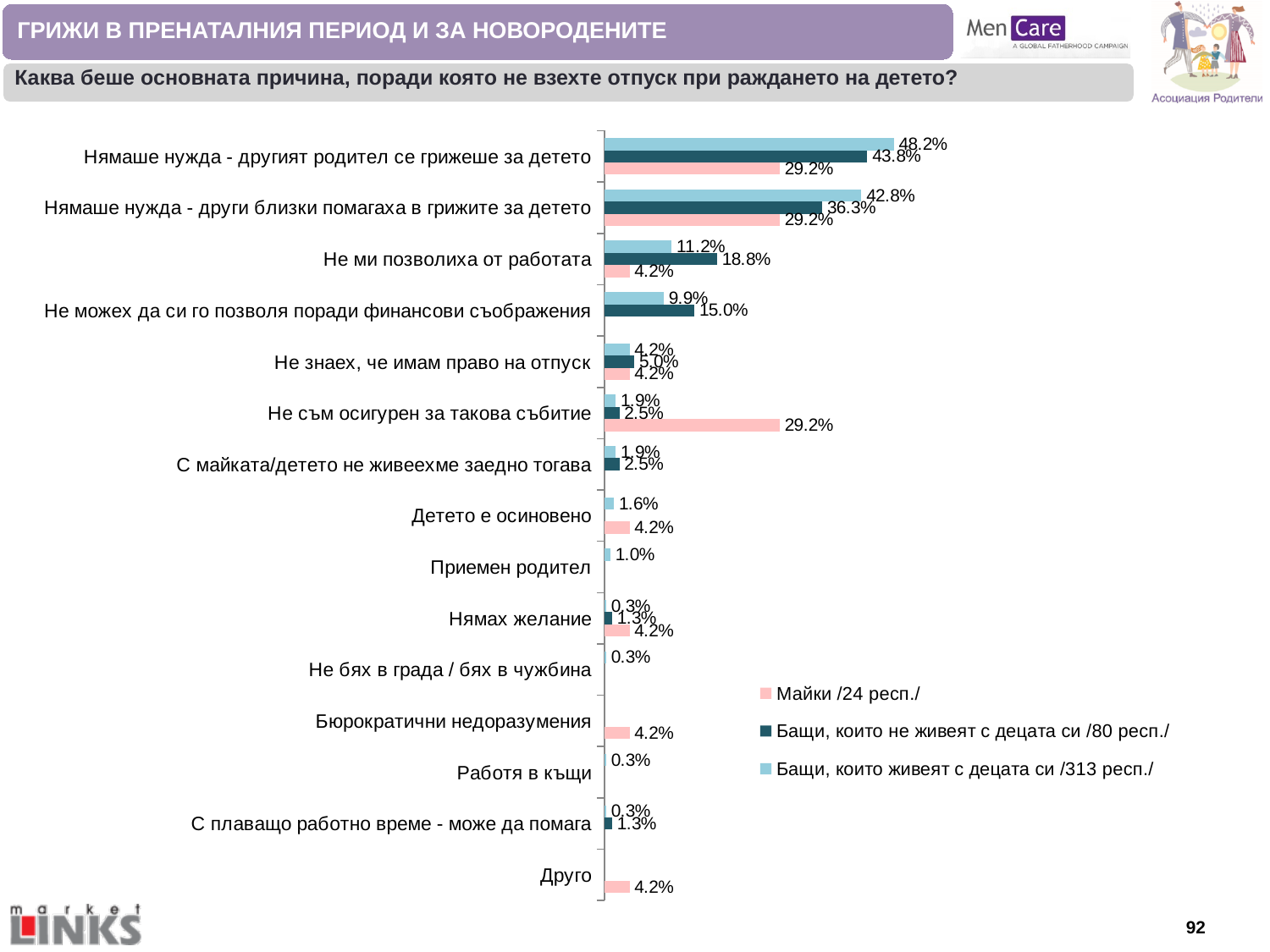
What is the value for 'Майки' for 'Не съм осигурен за такова събитие'? 29.2% What is the value for 'Бащи, които не живеят с децата си' for 'Не ми позволиха от работата'? 18.8% What is the value for 'Бащи, които живеят с децата си' for 'Нямаше нужда - другият родител се грижеше за детето'? 48.2% For 'Не ми позволиха от работата', which is larger: the value for 'Бащи, които живеят с децата си' or for 'Бащи, които не живеят с децата си'? Бащи, които не живеят с децата си How many series does the legend list? 3 What is the value for 'Майки' for 'Друго'? 4.2% Which category has the highest value for 'Бащи, които живеят с децата си'? Нямаше нужда - другият родител се грижеше за детето What is the difference between the 'Бащи, които живеят с децата си' and 'Бащи, които не живеят с децата си' values for 'Нямаше нужда - други близки помагаха в грижите за детето'? 6.5% What kind of chart is shown on the slide? bar chart How many respondents does the legend give for the 'Майки' series? 24 How many categories (reasons) are shown on the chart? 15 What is the value for 'Бащи, които не живеят с децата си' for 'Не можех да си го позволя поради финансови съображения'? 15.0%